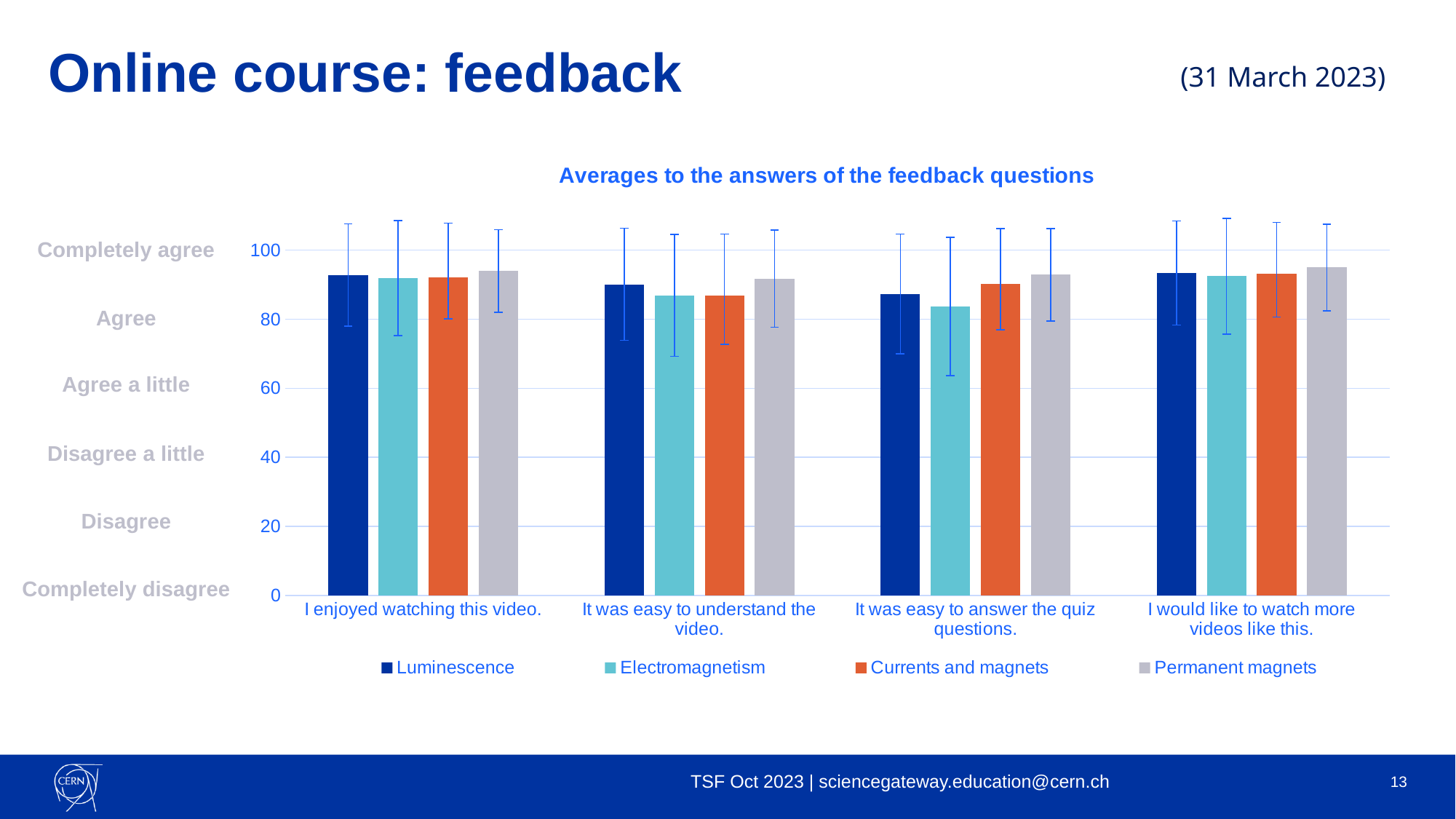
Is the value for Luminescence on "I enjoyed watching this video." greater or less than 80? greater Which series is shown in orange? Currents and magnets Is the value for Permanent magnets on "I would like to watch more videos like this." greater or less than 80? greater What is the title of the chart? Averages to the answers of the feedback questions For "It was easy to understand the video.", which is larger: Electromagnetism or Permanent magnets? Permanent magnets For "It was easy to answer the quiz questions.", which is larger: Electromagnetism or Permanent magnets? Permanent magnets How many feedback questions (categories) are shown on the x axis? 4 What kind of chart is shown on the slide? bar chart How many series does the legend list? 4 Is the value for Currents and magnets on "It was easy to understand the video." greater or less than 60? greater